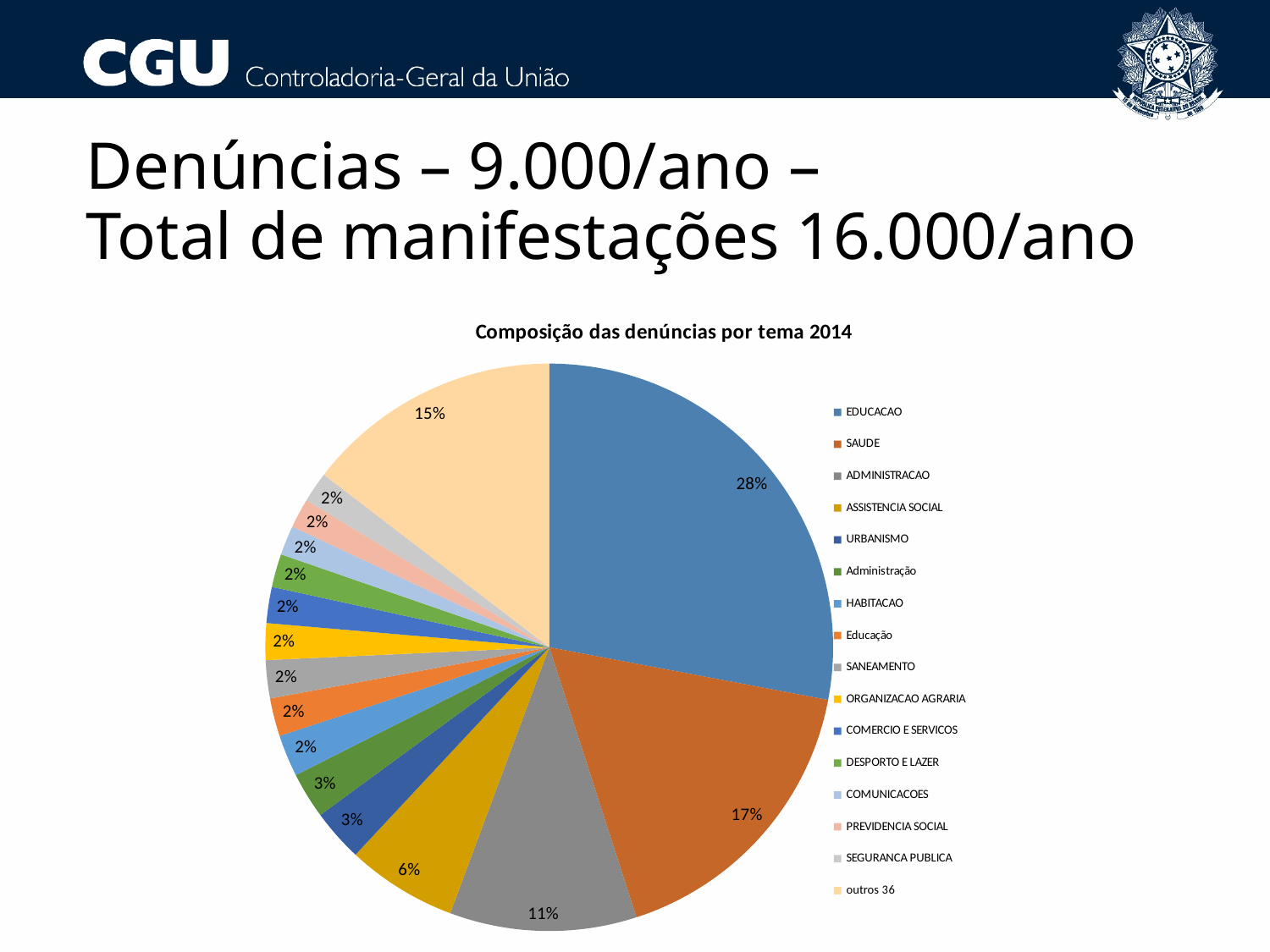
What is the title of the chart? Composição das denúncias por tema 2014 What share of the pie does SAUDE represent? 17% Which category has the largest slice of the pie? EDUCACAO What share of the pie does ADMINISTRACAO represent? 11% What is the difference in percentage points between the EDUCACAO slice and the SAUDE slice? 11 percentage points What kind of chart is shown on the slide? Pie chart What is the difference in percentage points between the ADMINISTRACAO slice and the ASSISTENCIA SOCIAL slice? 5 percentage points What share of the pie does EDUCACAO represent? 28% Which slice is larger, SAUDE or 'outros 36'? SAUDE How many categories does the legend of the pie chart list? 16